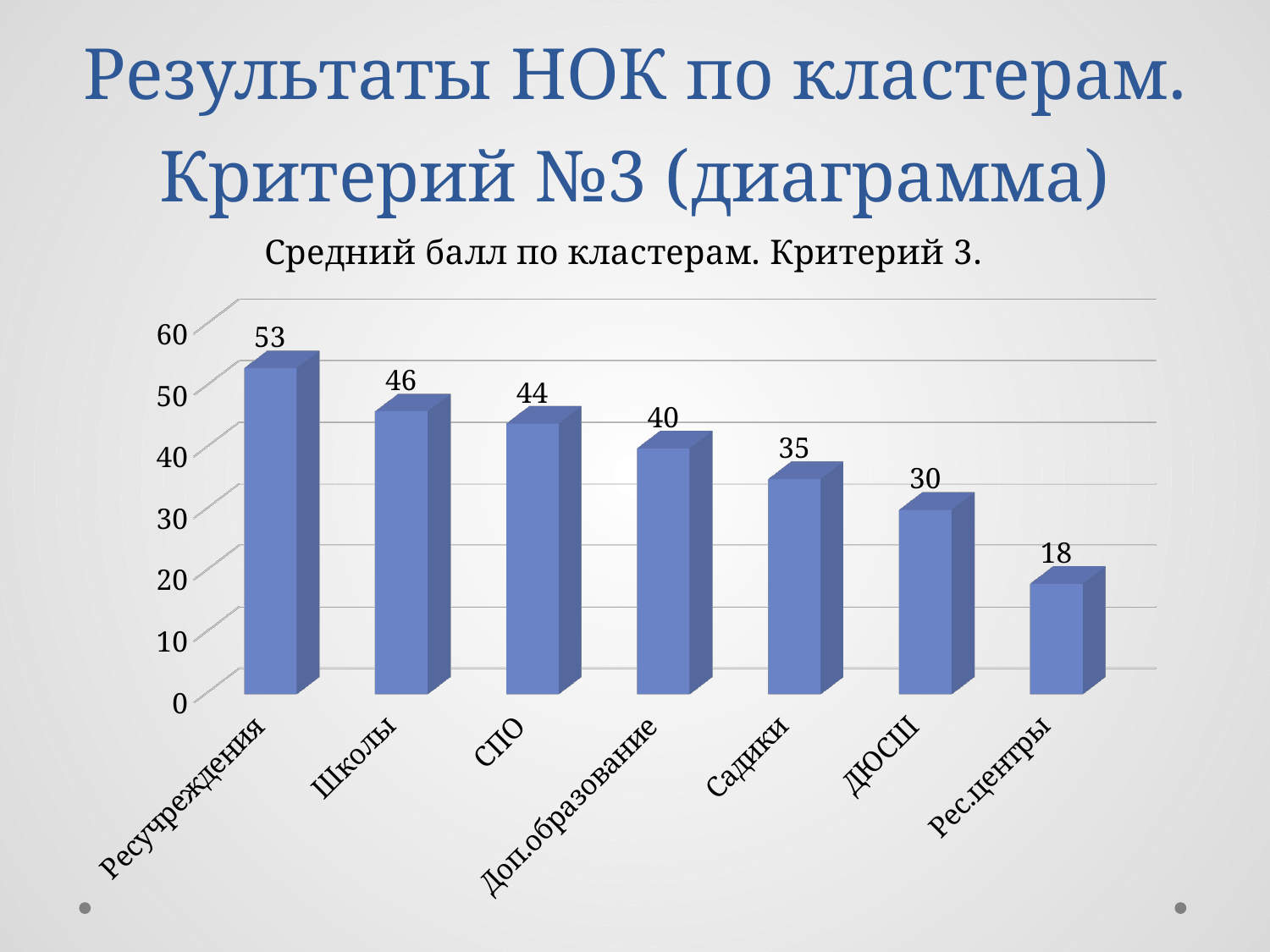
What is the value for Садики? 35 How many categories are shown on the chart? 7 What is the difference between the values for Ресучреждения and Школы? 7 Do the values rise or fall from left to right along the x axis? fall What is the value for Школы? 46 What kind of chart is shown on the slide? bar chart What is the value for Рес.центры? 18 Which is larger, the value for СПО or the value for Доп.образование? СПО Is the value for ДЮСШ greater or less than 40? less Which category has the lowest value? Рес.центры What is the difference between the values for ДЮСШ and Рес.центры? 12 Which category has the highest value? Ресучреждения